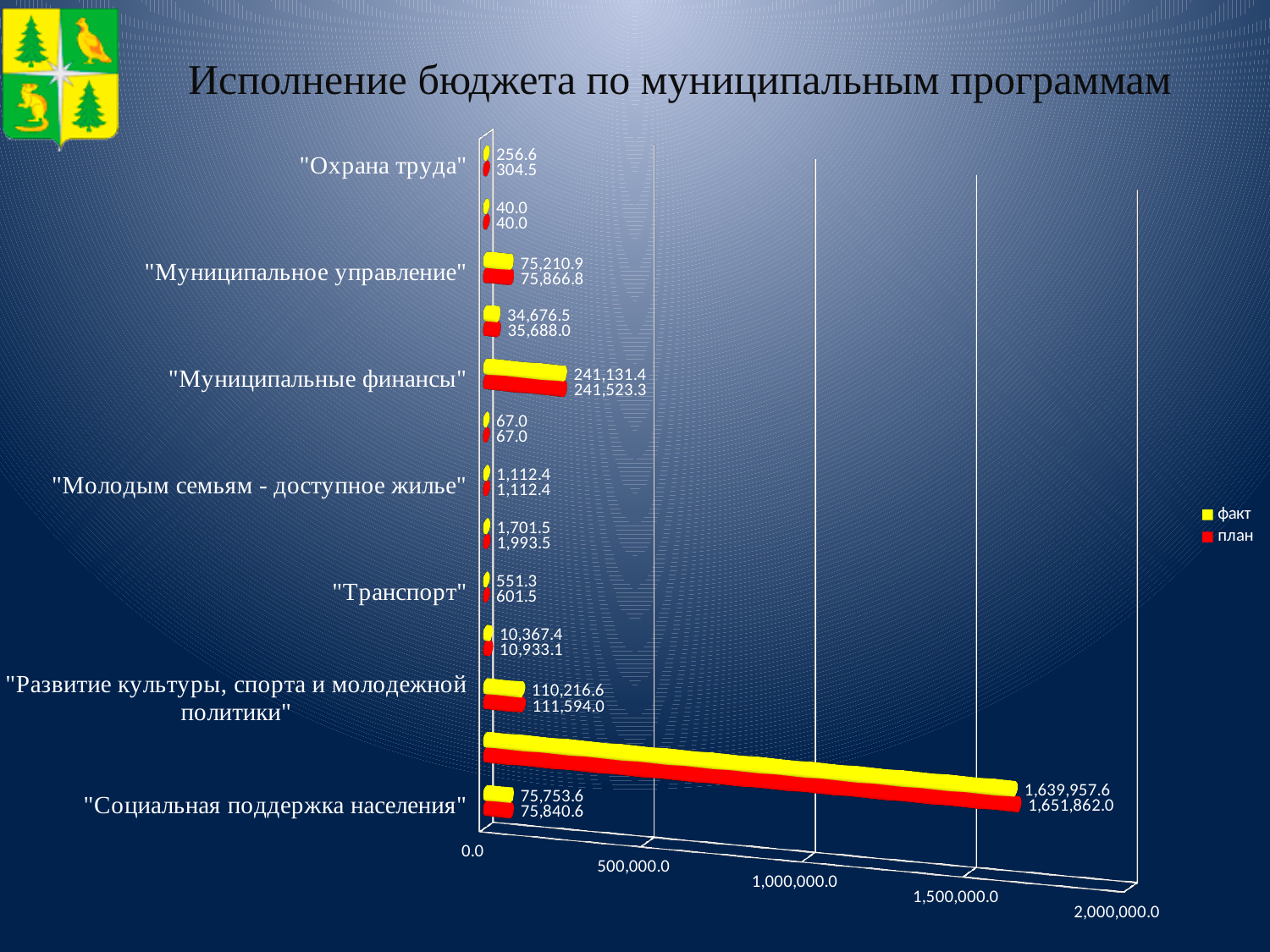
What is the факт value for "Молодым семьям - доступное жилье"? 1,112.4 What is the largest факт value shown on the chart? 1,639,957.6 What is the факт value for "Охрана труда"? 256.6 What is the план value for "Охрана труда"? 304.5 By how much does the план value exceed the факт value for "Транспорт"? 50.2 What is the план value for "Муниципальное управление"? 75,866.8 What type of chart is shown on the slide? Bar chart What is the факт value for "Развитие культуры, спорта и молодежной политики"? 110,216.6 Which has the larger факт value: "Муниципальные финансы" or "Муниципальное управление"? Муниципальные финансы What is the план value for "Транспорт"? 601.5 How many series does the legend list? 2 What is the факт value for "Муниципальные финансы"? 241,131.4